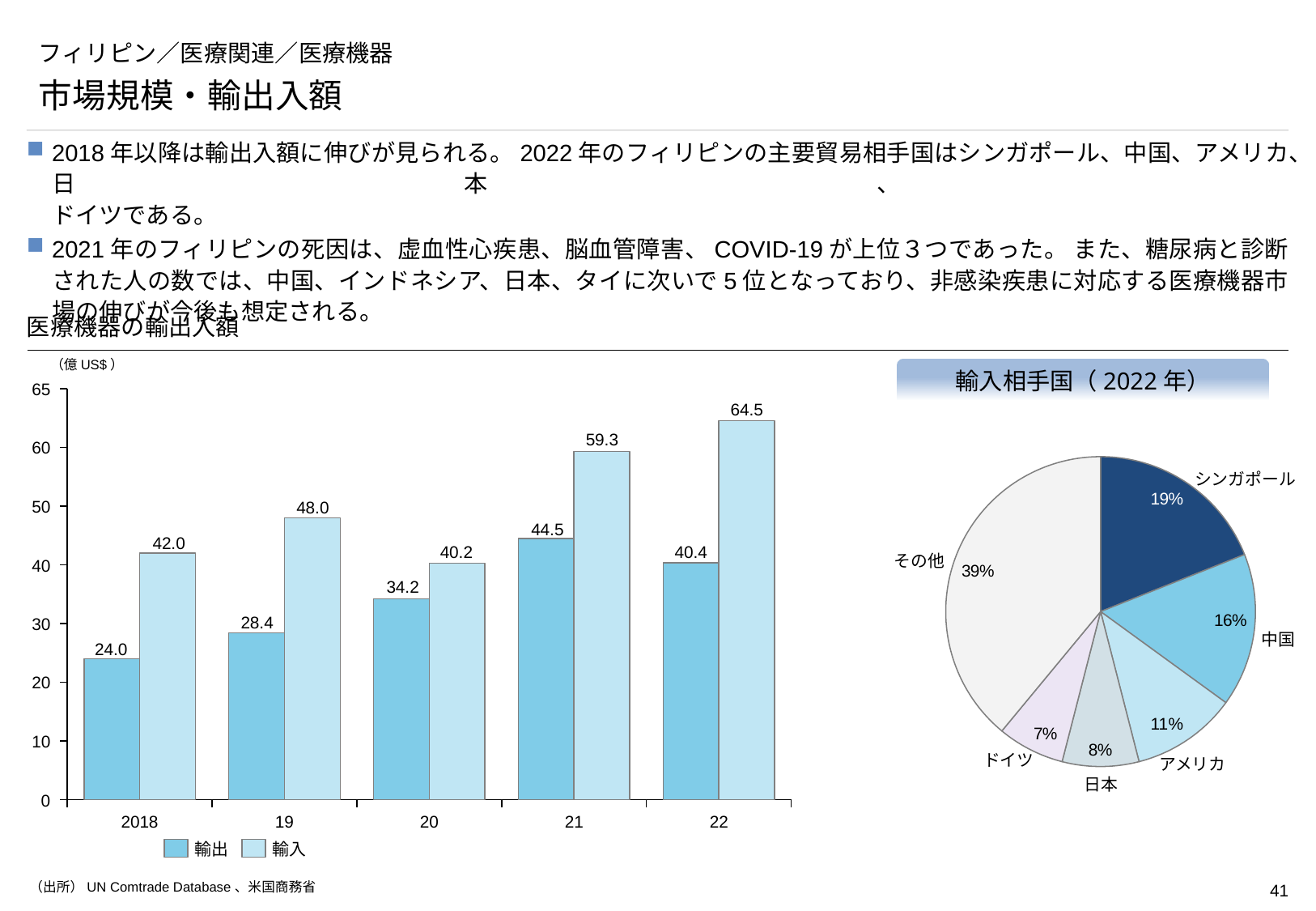
In the bar chart 医療機器の輸出入額, what is the difference between the 輸入 and 輸出 values for 22? 24.1 In the bar chart 医療機器の輸出入額, how many years are shown on the x axis? 5 In the pie chart 輸入相手国（2022年）, what share does シンガポール have? 19% In the pie chart 輸入相手国（2022年）, which named country has the smallest share? ドイツ In the bar chart 医療機器の輸出入額, which year has the lowest 輸出 value? 2018 In the bar chart 医療機器の輸出入額, which year has the highest 輸入 value? 22 In the bar chart 医療機器の輸出入額, does the 輸入 value rise or fall from 2018 to 22? rise In the bar chart 医療機器の輸出入額, which is larger for 20, 輸出 or 輸入? 輸入 In the bar chart 医療機器の輸出入額, what is the 輸出 value for 21? 44.5 What kind of chart is 輸入相手国（2022年）? pie chart In the bar chart 医療機器の輸出入額, what is the 輸入 value for 2018? 42.0 In the bar chart 医療機器の輸出入額, how many series does the legend list? 2